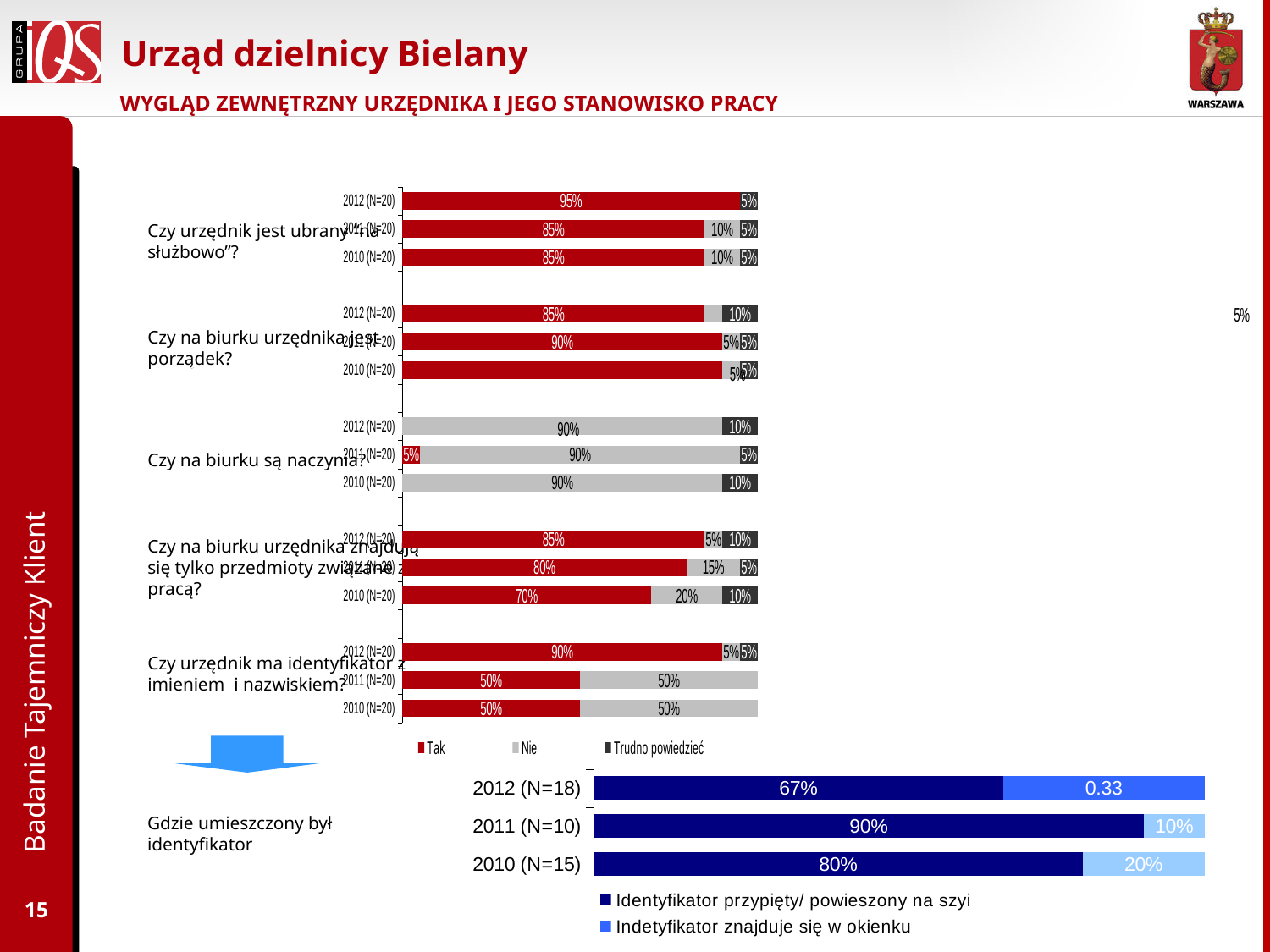
In the top chart, what percentage answered 'Tak' to 'Czy urzędnik jest ubrany na służbowo?' in 2012 (N=20)? 95% In the top chart, what percentage answered 'Tak' to 'Czy na biurku urzędnika znajdują się tylko przedmioty związane z pracą?' in 2010 (N=20)? 70% In the top chart, what percentage answered 'Nie' to 'Czy urzędnik jest ubrany na służbowo?' in 2011 (N=20)? 10% What type of chart is the top chart? Stacked bar chart In the top chart, what percentage answered 'Tak' to 'Czy urzędnik ma identyfikator z imieniem i nazwiskiem?' in 2012 (N=20)? 90% In the top chart, what percentage answered 'Nie' to 'Czy na biurku urzędnika znajdują się tylko przedmioty związane z pracą?' in 2011 (N=20)? 15% In the top chart, by how many percentage points did the 'Tak' share for 'Czy urzędnik ma identyfikator z imieniem i nazwiskiem?' rise from 2011 to 2012? 40 percentage points In the top chart, for 'Czy na biurku urzędnika znajdują się tylko przedmioty związane z pracą?', which year has the highest 'Tak' share? 2012 (N=20) In the bottom chart 'Gdzie umieszczony był identyfikator', which year has the lowest share for 'Identyfikator przypięty/ powieszony na szyi'? 2012 (N=18) How many series does the legend of the top chart list? 3 In the bottom chart 'Gdzie umieszczony był identyfikator', what is the value for 'Identyfikator przypięty/ powieszony na szyi' in 2011 (N=10)? 90%